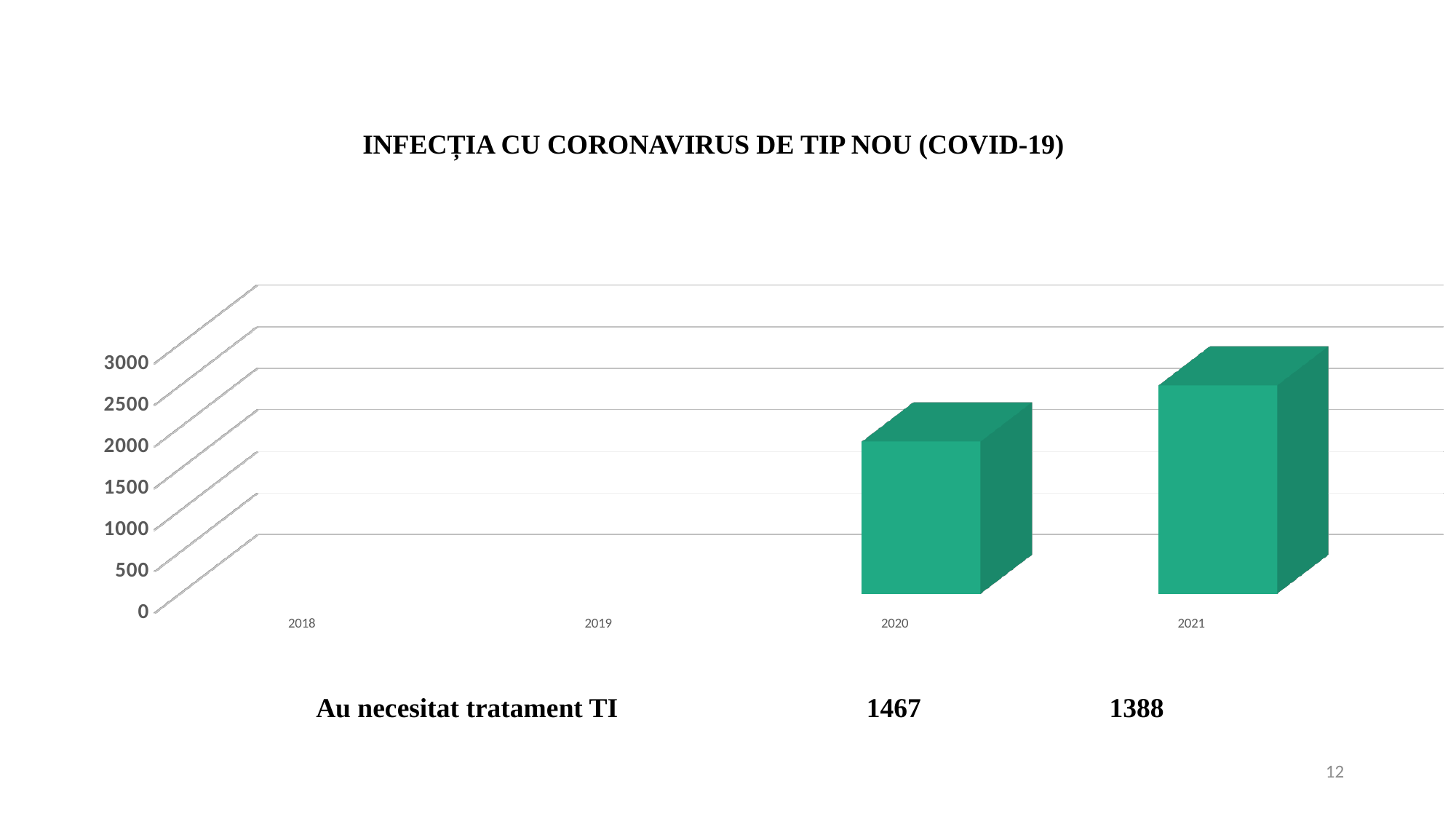
Is the value for 2021 greater or less than 3000? less Do the values rise or fall from 2020 to 2021? rise How many categories are shown on the x axis of the chart? 4 Is the value for 2020 greater or less than 1500? greater What kind of chart is shown on the slide? bar chart Which is larger, the value for 2020 or the value for 2021? 2021 What is the highest value labelled on the vertical axis of the chart? 3000 How many bars are plotted in the chart? 2 What is the title of the chart? INFECȚIA CU CORONAVIRUS DE TIP NOU (COVID-19) Is the value for 2020 greater or less than 2500? less Which year has the highest bar in the chart? 2021